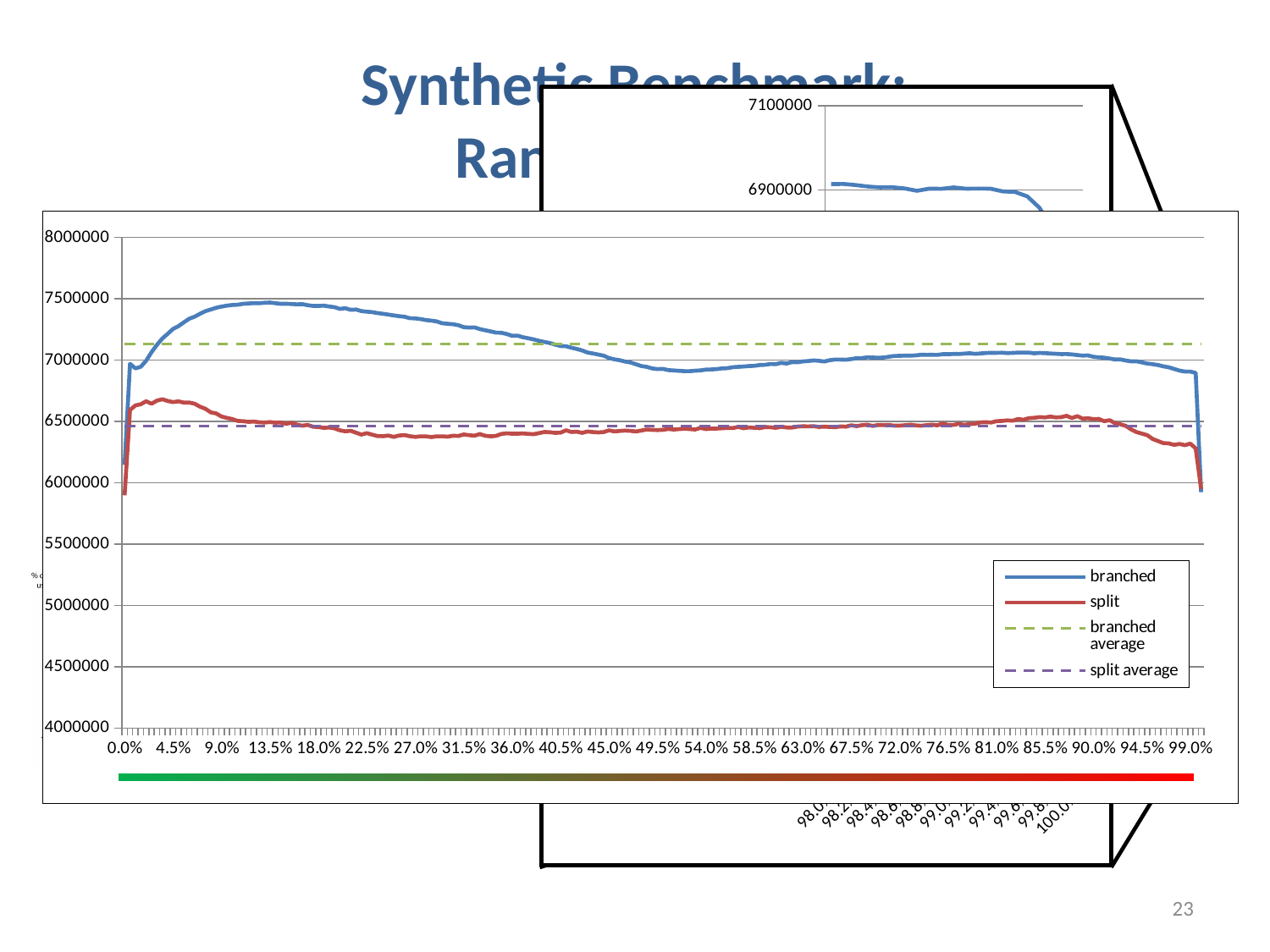
On the main chart, is the value of the split series at 27.0% greater or less than 6500000? less On the main chart, is the branched average line above or below 7000000? above On the main chart, what colour is the branched series line? blue On the main chart, is the value of the branched series at 13.5% greater or less than 7000000? greater On the main chart, how many series does the legend list? 4 On the main chart, which legend entries are drawn as dashed lines? branched average and split average On the main chart, which is higher, the branched average line or the split average line? branched average On the main chart, does the branched series rise or fall between 13.5% and 49.5%? fall On the main chart, which series has the larger value at 13.5%, branched or split? branched What kind of chart is the main chart on the slide? line chart